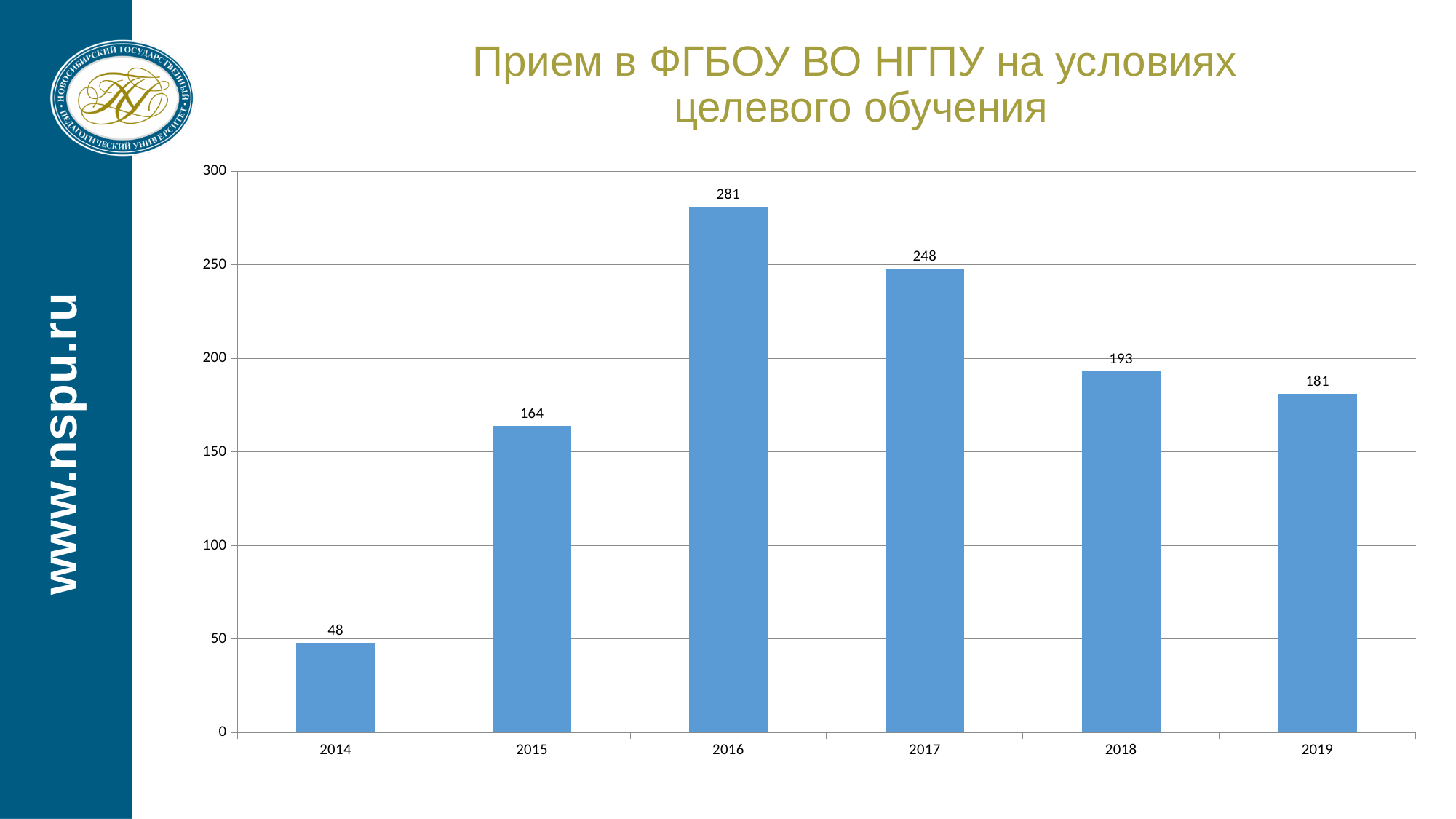
Do the values rise or fall from 2016 to 2019? fall Which year has the lowest value? 2014 Is the value for 2017 greater or less than 200? greater What is the value for 2019? 181 What kind of chart is shown on the slide? bar chart Which year has the highest value? 2016 How many years are shown on the x axis? 6 What is the difference between the values for 2015 and 2014? 116 What is the value for 2016? 281 Which is larger, the value for 2018 or the value for 2019? 2018 What is the value for 2014? 48 What is the difference between the values for 2016 and 2017? 33